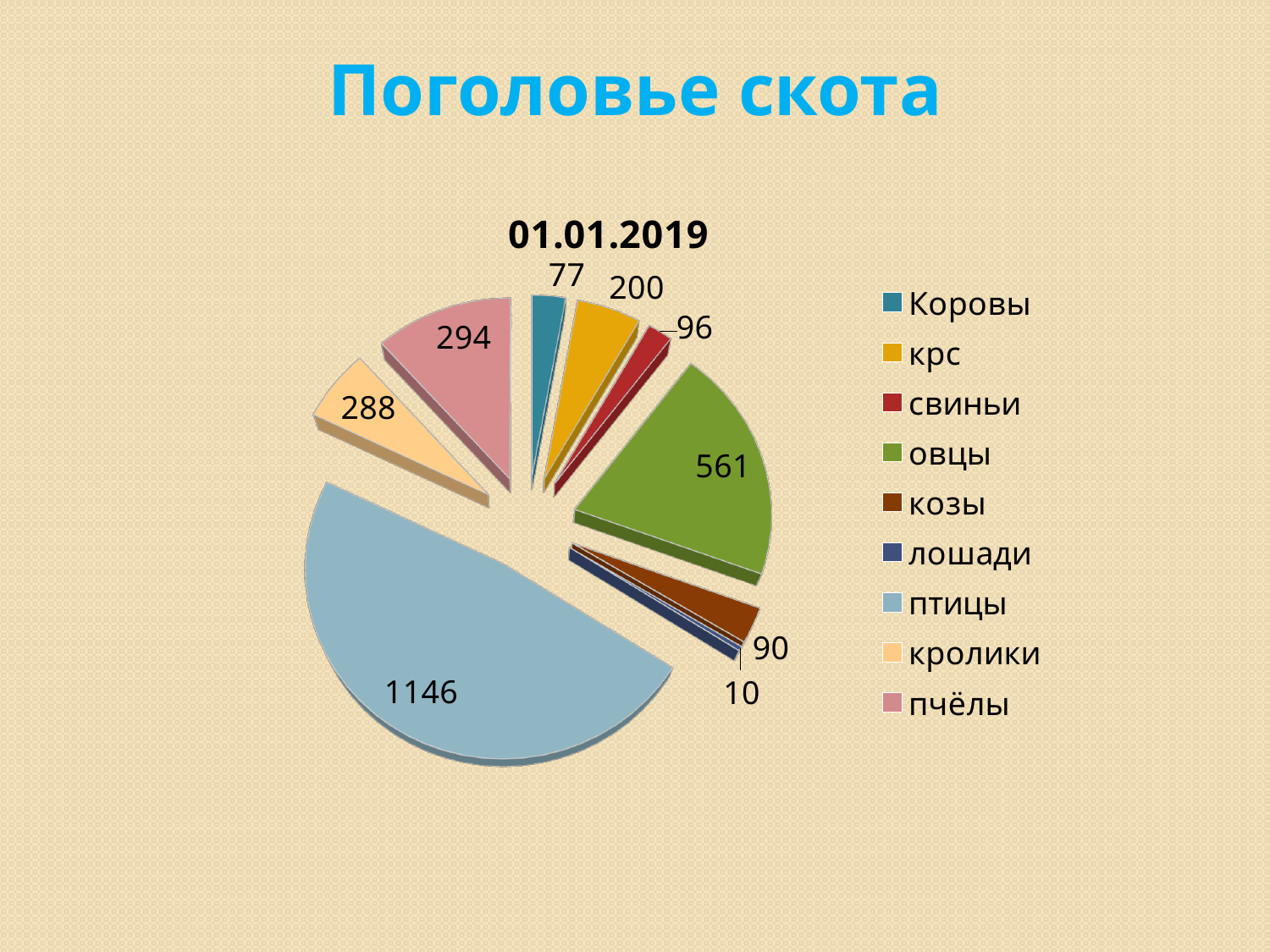
What is the value for птицы? 1146 Which category has the largest slice? птицы What is the difference between the values for птицы and овцы? 585 What is the value for Коровы? 77 What is the value for лошади? 10 What is the title shown above the pie chart? 01.01.2019 What is the value for овцы? 561 Which is larger, the value for кролики or the value for пчёлы? пчёлы Which category has the smallest slice? лошади What is the difference between the values for крс and свиньи? 104 How many categories does the legend list? 9 What kind of chart is shown on the slide? pie chart